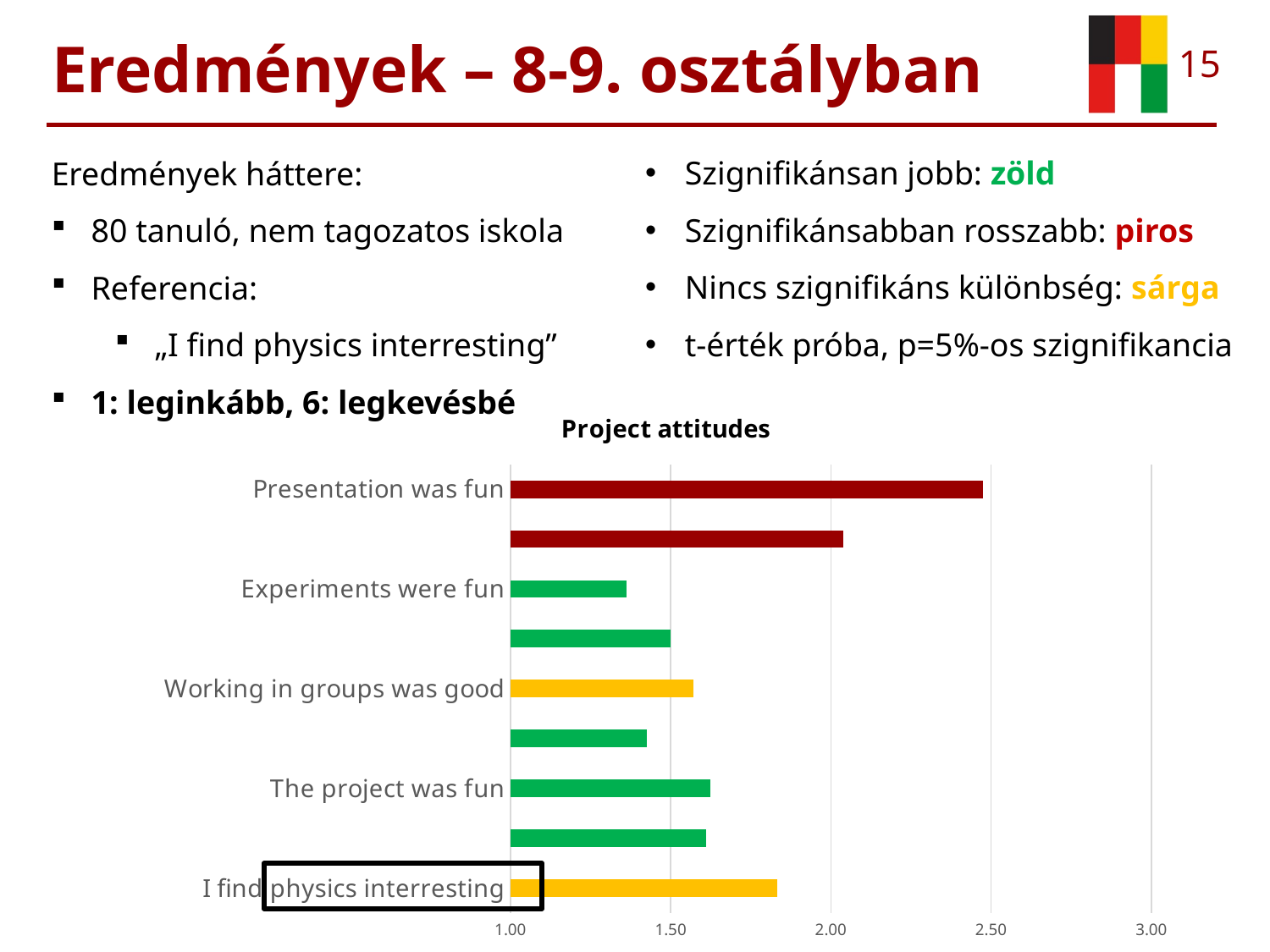
Is the value for "Presentation was fun" greater or less than 2.00? greater Is the value for "Working in groups was good" greater or less than 1.50? greater Is the value for "The project was fun" greater or less than 2.00? less What colour is the bar for "Presentation was fun"? red Which labelled category has the shortest bar in the chart? Experiments were fun What kind of chart is shown on the slide? bar chart What is the title of the chart? Project attitudes Which is larger, the value for "I find physics interresting" or the value for "Experiments were fun"? I find physics interresting Which labelled category has the longest bar in the chart? Presentation was fun Which is larger, the value for "Presentation was fun" or the value for "The project was fun"? Presentation was fun